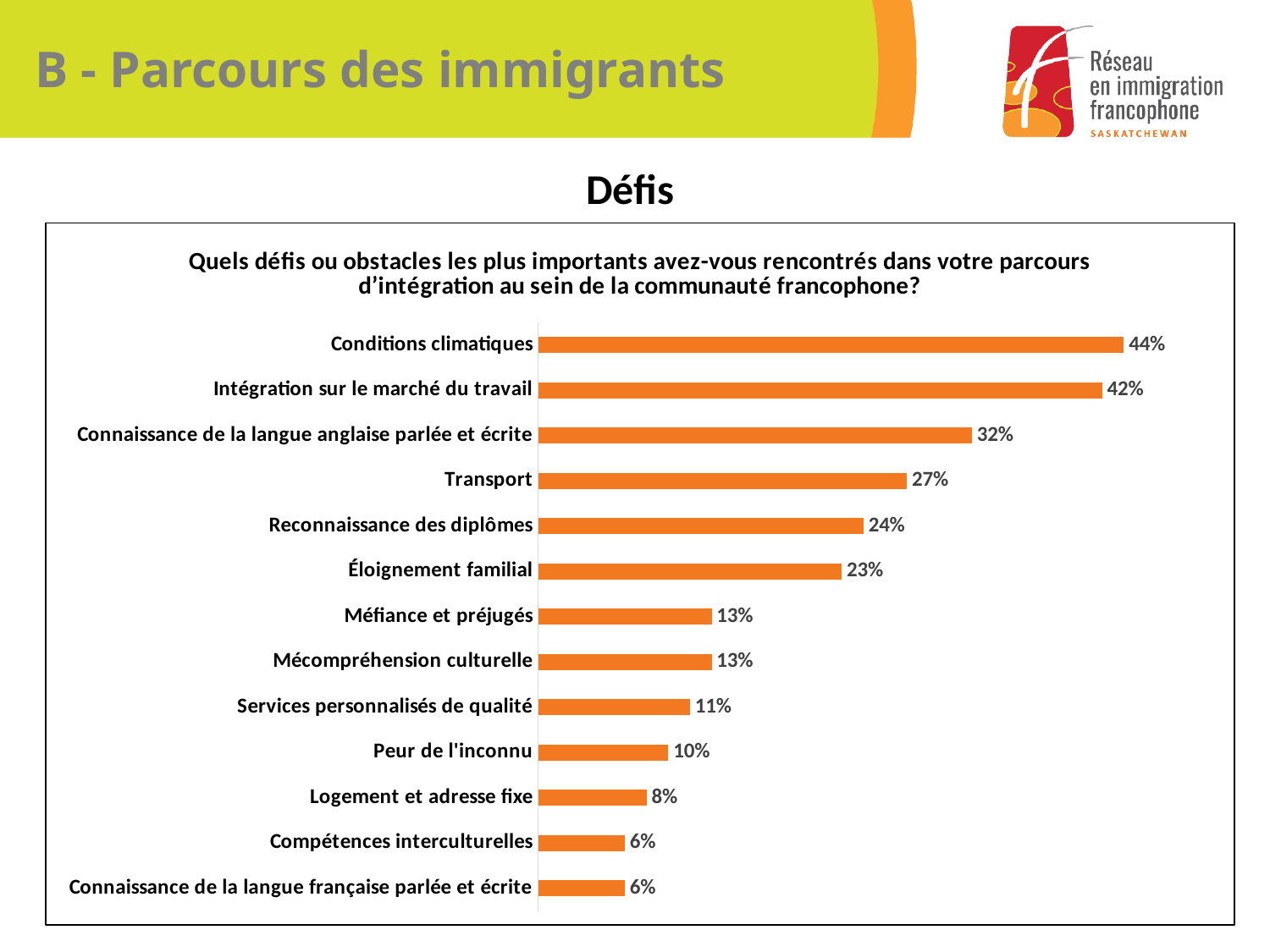
What is the value for Logement et adresse fixe? 8% Which is larger, Reconnaissance des diplômes or Éloignement familial? Reconnaissance des diplômes What is the title of the chart? Quels défis ou obstacles les plus importants avez-vous rencontrés dans votre parcours d'intégration au sein de la communauté francophone? What is the difference between Conditions climatiques and Compétences interculturelles? 38% Which is larger, Services personnalisés de qualité or Méfiance et préjugés? Méfiance et préjugés What is the value for Transport? 27% How many categories are shown in the chart? 13 What is the value for Conditions climatiques? 44% What is the value for Peur de l'inconnu? 10% What kind of chart is this? bar chart What is the difference between Intégration sur le marché du travail and Connaissance de la langue anglaise parlée et écrite? 10% Which category has the highest value? Conditions climatiques